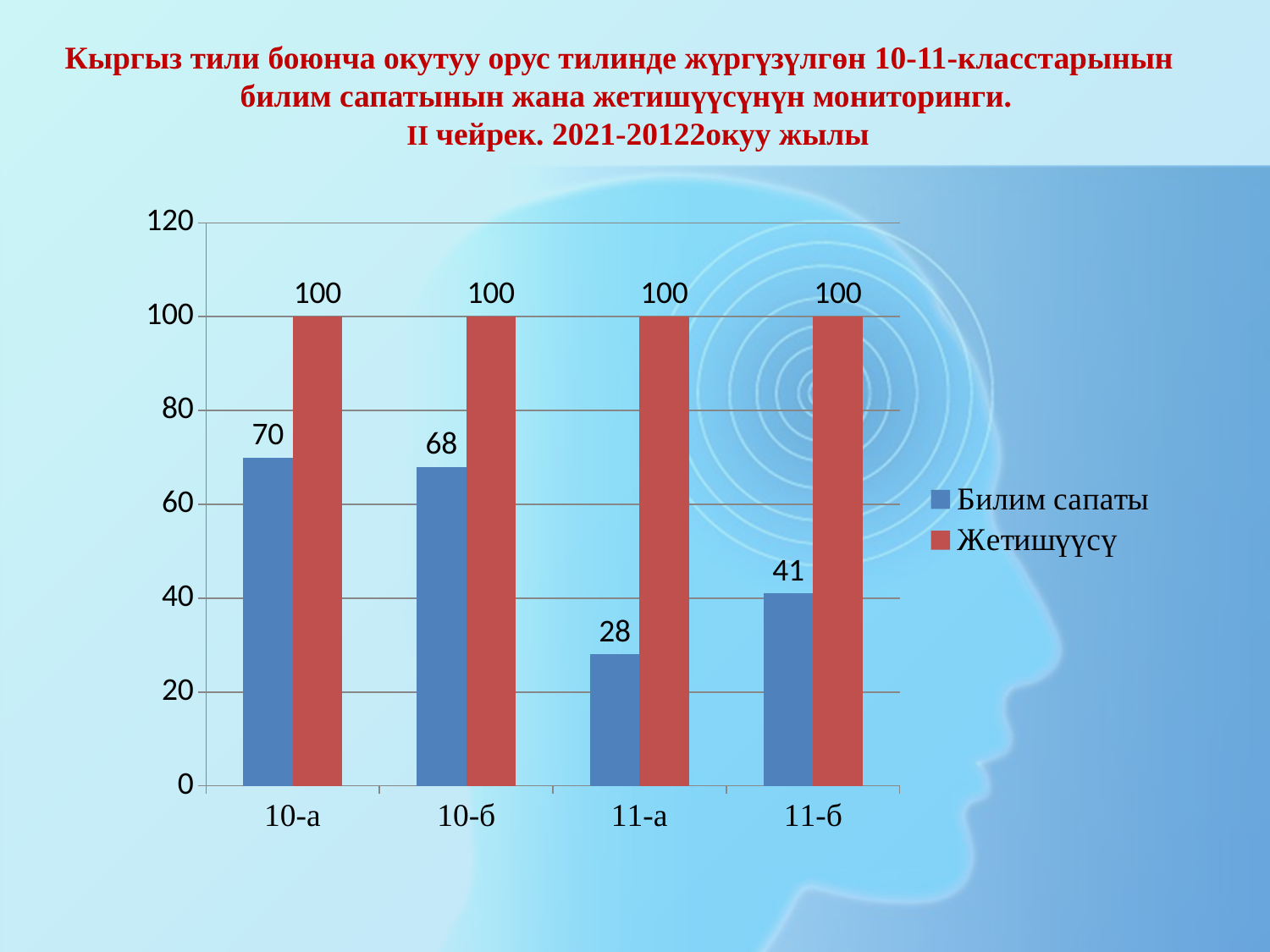
Which class has the highest Билим сапаты value? 10-а How many classes are shown on the x axis? 4 What is the difference between the Билим сапаты values for 11-б and 11-а? 13 What is the value of Жетишүүсү for 11-б? 100 Which series is shown in red? Жетишүүсү What kind of chart is shown on the slide? bar chart How many series does the legend list? 2 Which class has the lowest Билим сапаты value? 11-а What is the value of Билим сапаты for 11-а? 28 What is the difference between the Билим сапаты values for 10-а and 11-а? 42 Which is larger, the Билим сапаты value for 10-б or for 11-б? 10-б What is the value of Билим сапаты for 10-а? 70